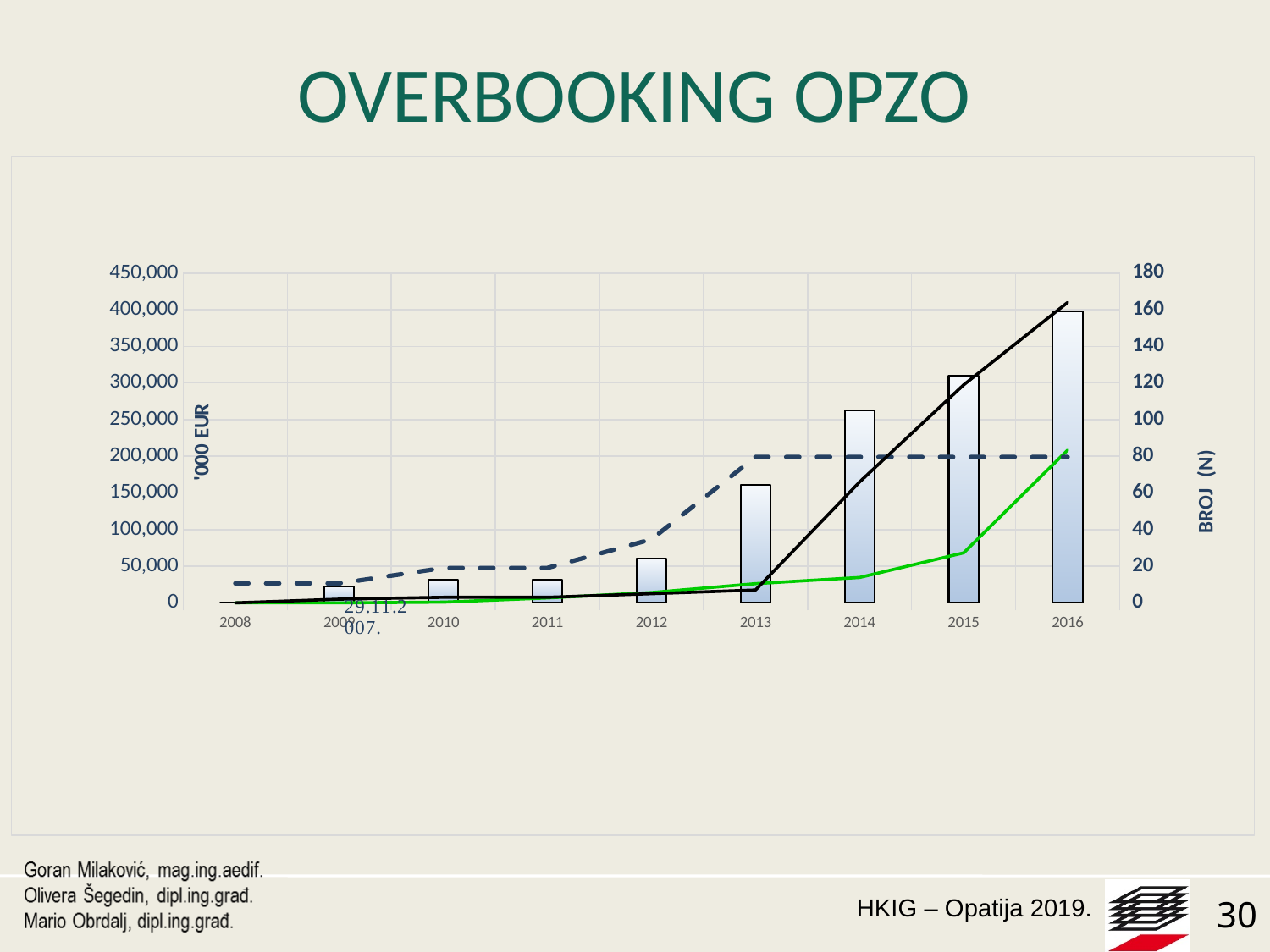
Is the bar value for 2016 greater or less than 350,000? greater Do the bar values generally rise or fall from 2008 to 2016? rise Is the bar value for 2014 greater or less than 200,000? greater What kind of chart is shown on the slide? A combined bar and line chart What is the label of the left vertical axis? '000 EUR Is the bar value for 2012 greater or less than 100,000? less Which bar is taller, 2015 or 2016? 2016 Which year has the tallest bar in the chart? 2016 How many years are shown on the x axis of the chart? 9 What is the label of the right vertical axis? BROJ (N)